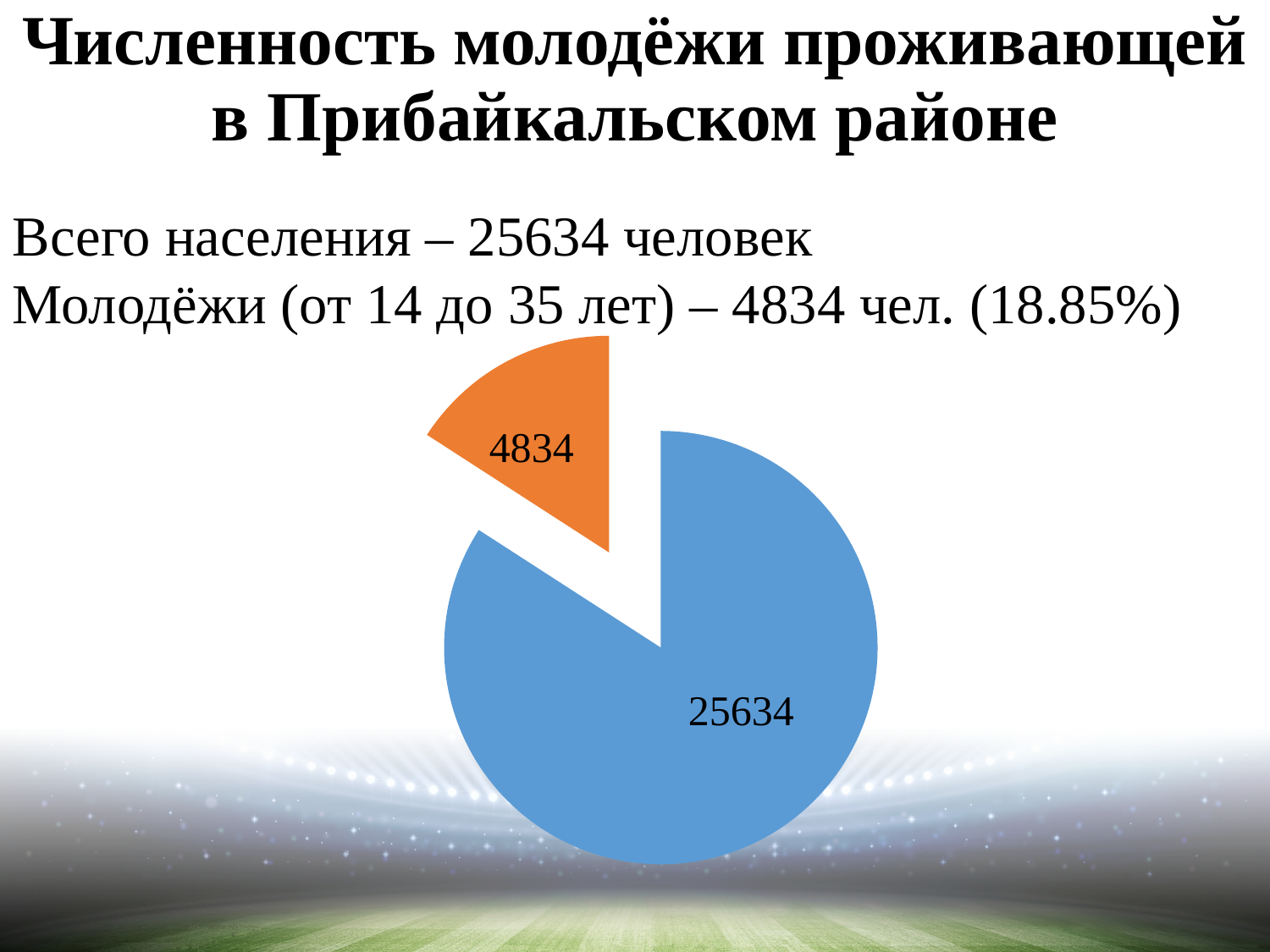
Which slice of the pie chart has the smallest value? the orange slice (4834) What is the difference between the values of the blue slice and the orange slice? 20800 How many slices does the pie chart have? 2 What value is labelled on the orange slice of the pie chart? 4834 What value is labelled on the blue slice of the pie chart? 25634 Which is larger, the blue slice or the orange slice of the pie chart? the blue slice Which slice of the pie chart has the largest value? the blue slice (25634) What is the title of the slide containing the pie chart? Численность молодёжи проживающей в Прибайкальском районе What kind of chart is shown on the slide? pie chart What colour is the slice labelled 4834 in the pie chart? orange